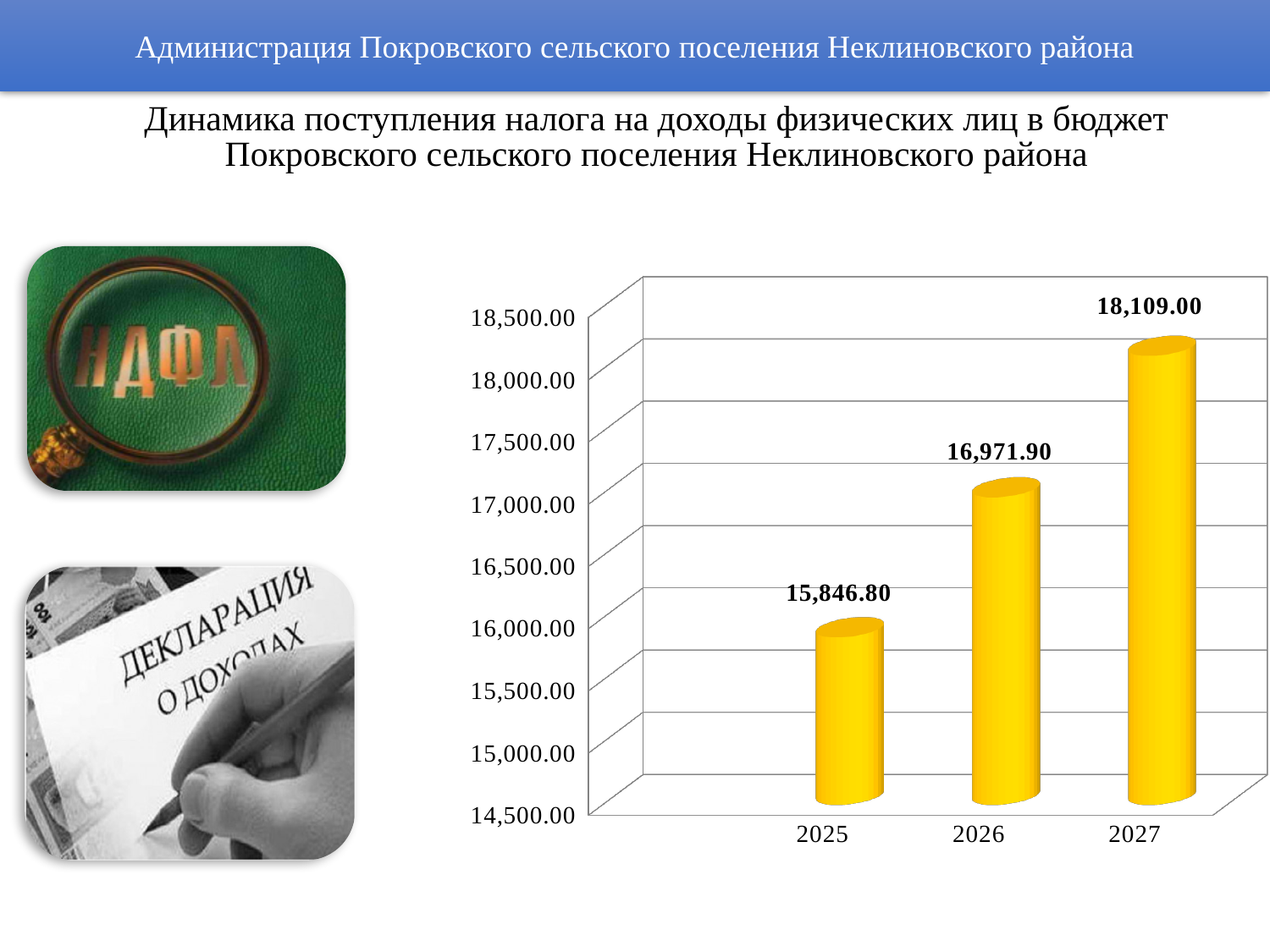
Which year has the lowest value? 2025 Which year has the highest value? 2027 What is the value shown for 2027? 18,109.00 What is the value shown for 2025? 15,846.80 What is the difference between the values for 2026 and 2025? 1,125.10 Do the values rise or fall from 2025 to 2027? rise What kind of chart is shown on the slide? bar chart Which is larger, the value for 2026 or the value for 2027? 2027 Is the value for 2025 greater or less than 16,000.00? less What is the difference between the values for 2027 and 2026? 1,137.10 What is the value shown for 2026? 16,971.90 How many years are shown on the x axis? 3